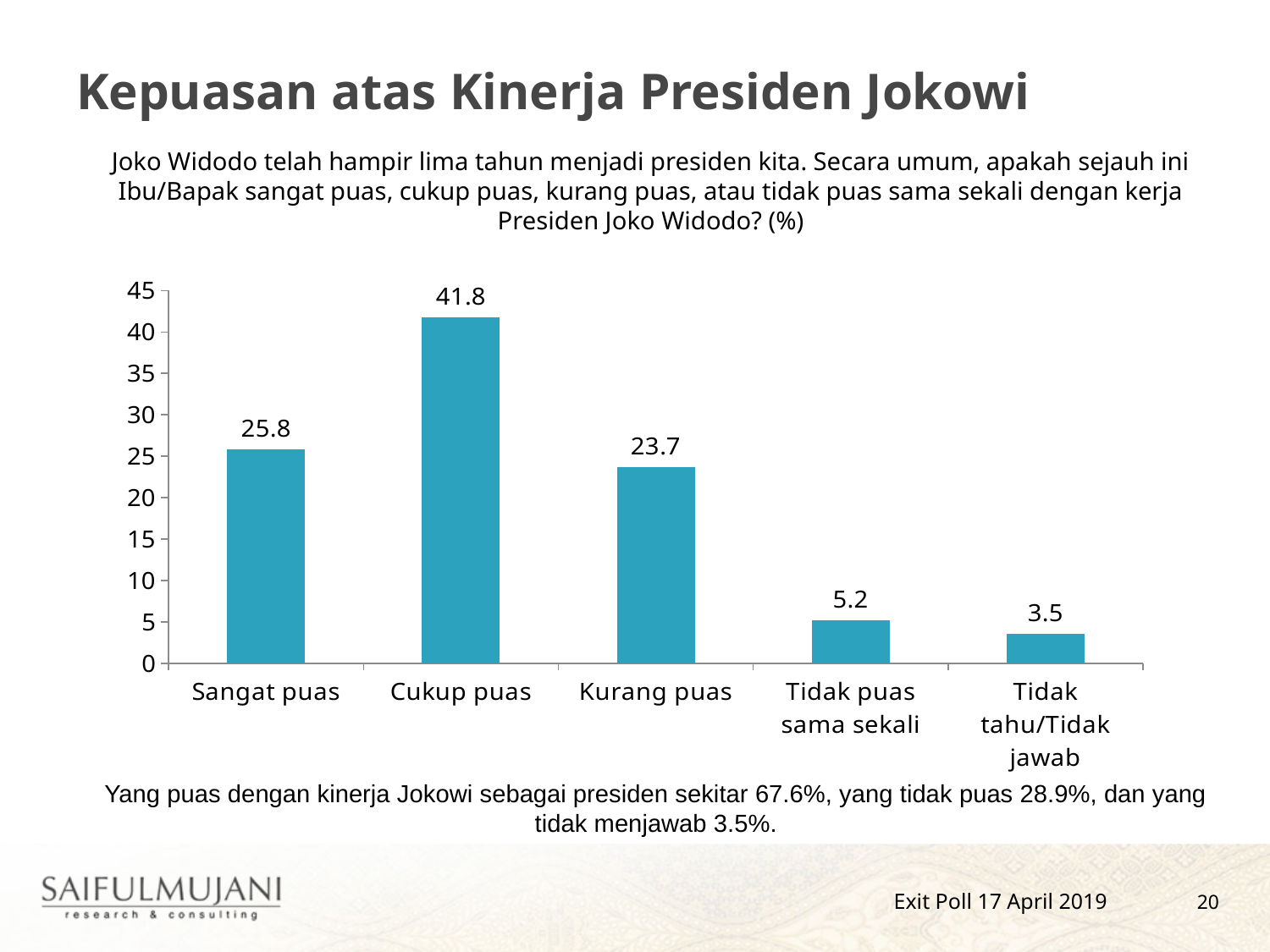
How many categories are shown on the x axis? 5 What is the value for Cukup puas? 41.8 Which category has the highest value? Cukup puas What kind of chart is shown on the slide? Bar chart What is the difference between the values for Cukup puas and Kurang puas? 18.1 What is the value for Sangat puas? 25.8 What is the value for Tidak puas sama sekali? 5.2 Which is larger, the value for Sangat puas or the value for Kurang puas? Sangat puas What is the difference between the values for Sangat puas and Tidak puas sama sekali? 20.6 What is the value for Tidak tahu/Tidak jawab? 3.5 Which category has the lowest value? Tidak tahu/Tidak jawab Is the value for Kurang puas greater or less than 20? greater